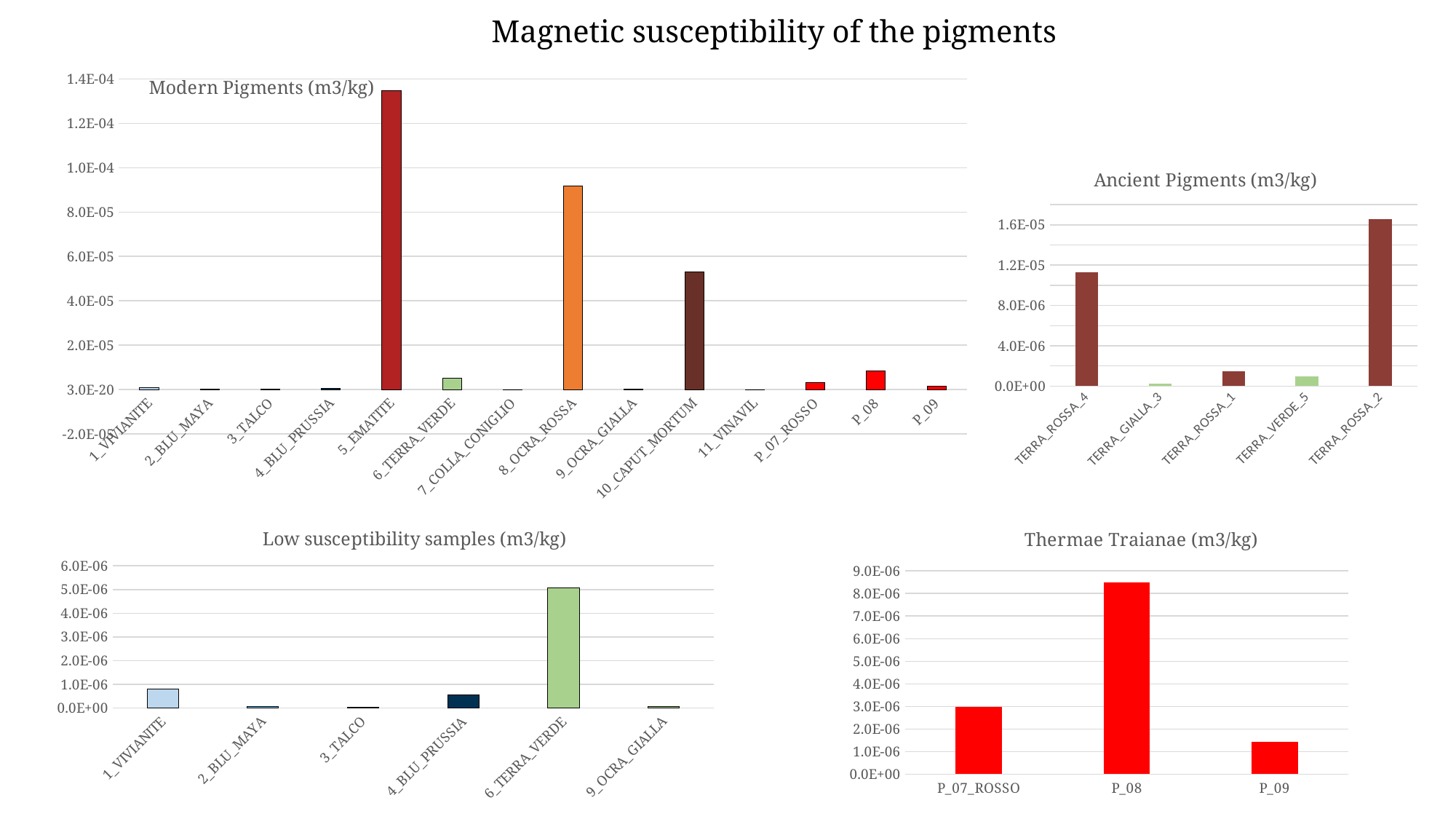
How many pigments are plotted in the Modern Pigments chart? 14 In the Ancient Pigments chart, which sample has the highest value? TERRA_ROSSA_2 In the Ancient Pigments chart, is the value for TERRA_ROSSA_4 greater or less than 8.0E-06? greater In the Modern Pigments chart, which pigment has the highest magnetic susceptibility? 5_EMATITE In the Modern Pigments chart, is the value for 10_CAPUT_MORTUM greater or less than 6.0E-05? less In the Low susceptibility samples chart, which sample has the highest value? 6_TERRA_VERDE In the Thermae Traianae chart, which of P_07_ROSSO and P_08 has the larger value? P_08 In the Modern Pigments chart, is the value for 5_EMATITE greater or less than 1.2E-04? greater What type of chart is the Thermae Traianae chart? bar chart In the Ancient Pigments chart, which sample has the lowest value? TERRA_GIALLA_3